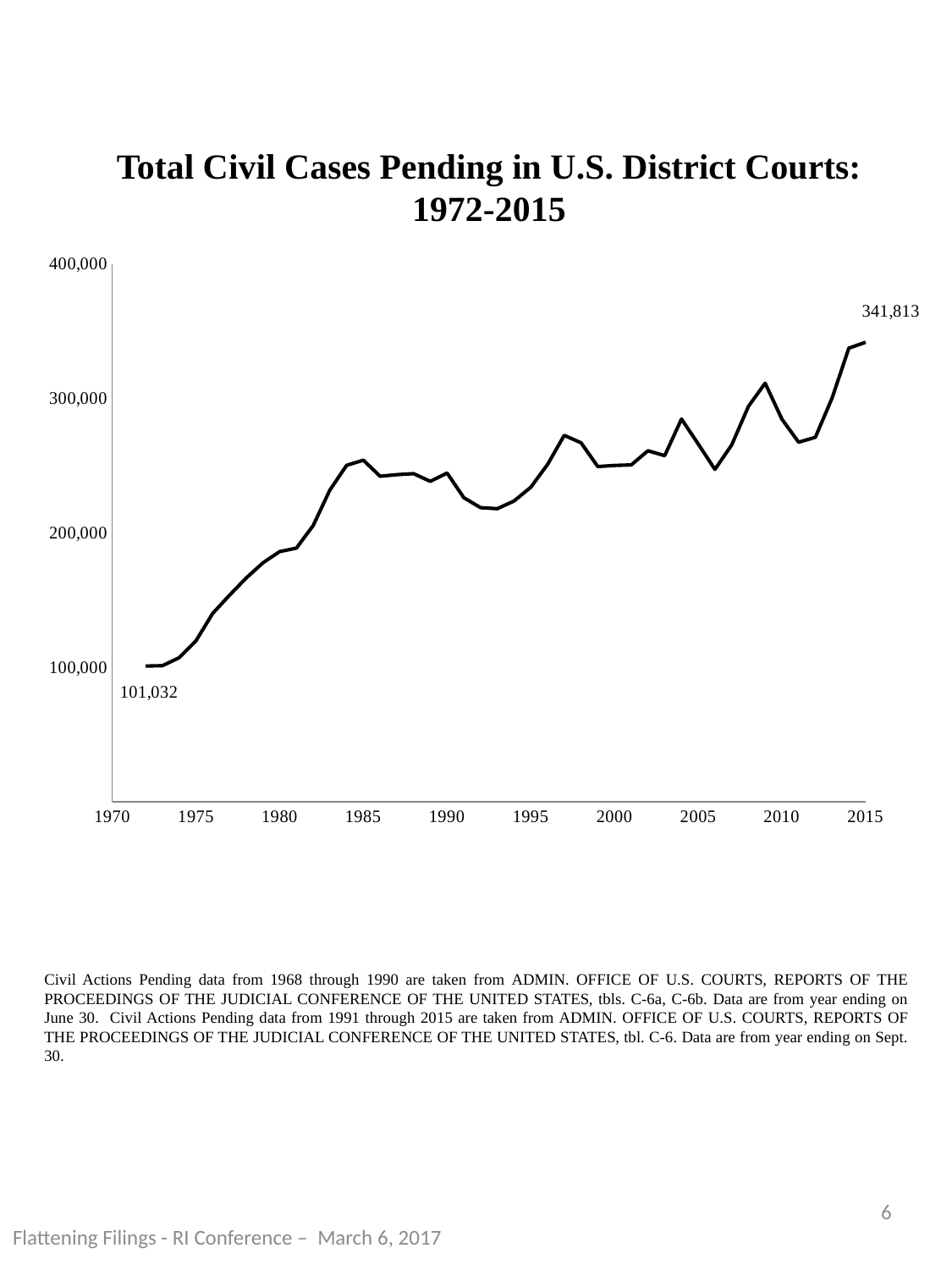
What is the value shown for 2015? 341,813 What kind of chart is shown on the slide? line chart What is the difference between the 2015 value and the 1972 value? 240,781 Which is larger, the value for 1975 or the value for 1985? 1985 Is the value for 1980 greater or less than 200,000? less What is the title of the chart? Total Civil Cases Pending in U.S. District Courts: 1972-2015 What is the value shown for 1972? 101,032 Is the value for 2006 greater or less than 300,000? less Which year has the lowest value on the chart? 1972 Is the value for 1985 greater or less than 200,000? greater Do the values generally rise or fall from 1972 to 2015? rise Which year has the highest value on the chart? 2015